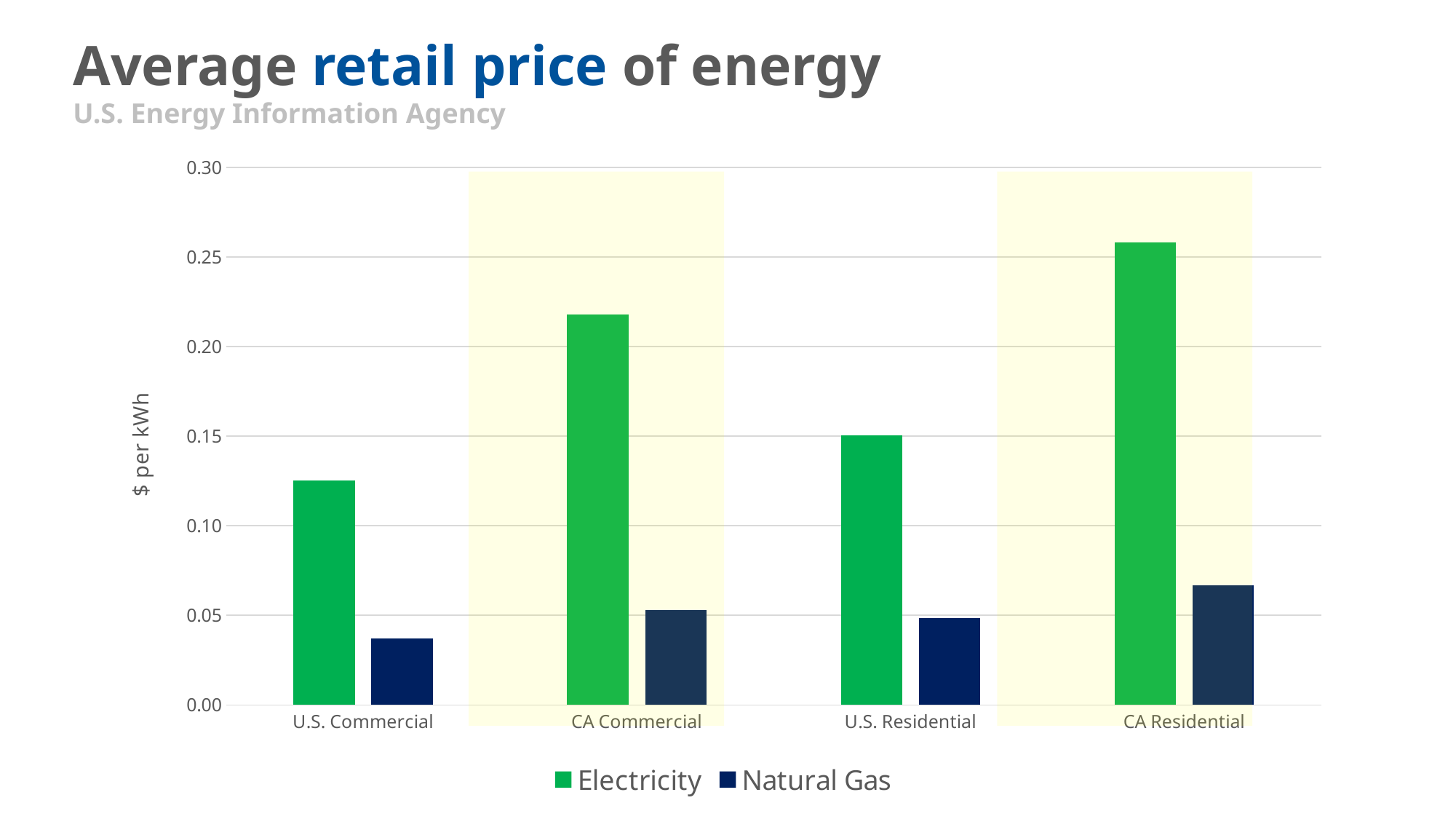
Which category has the lowest Natural Gas price? U.S. Commercial What kind of chart is shown on the slide? bar chart Which category has the lowest Electricity price? U.S. Commercial What is the label on the y axis? $ per kWh How many categories are shown on the x axis? 4 Is the Electricity value for CA Commercial greater or less than 0.20? greater Is the Electricity value for U.S. Commercial greater or less than 0.10? greater Which category has the highest Natural Gas price? CA Residential Is the Natural Gas value for U.S. Commercial greater or less than 0.05? less Which category has the highest Electricity price? CA Residential How many series does the legend list? 2 Which is larger: the Electricity value for CA Commercial or the Electricity value for U.S. Residential? CA Commercial